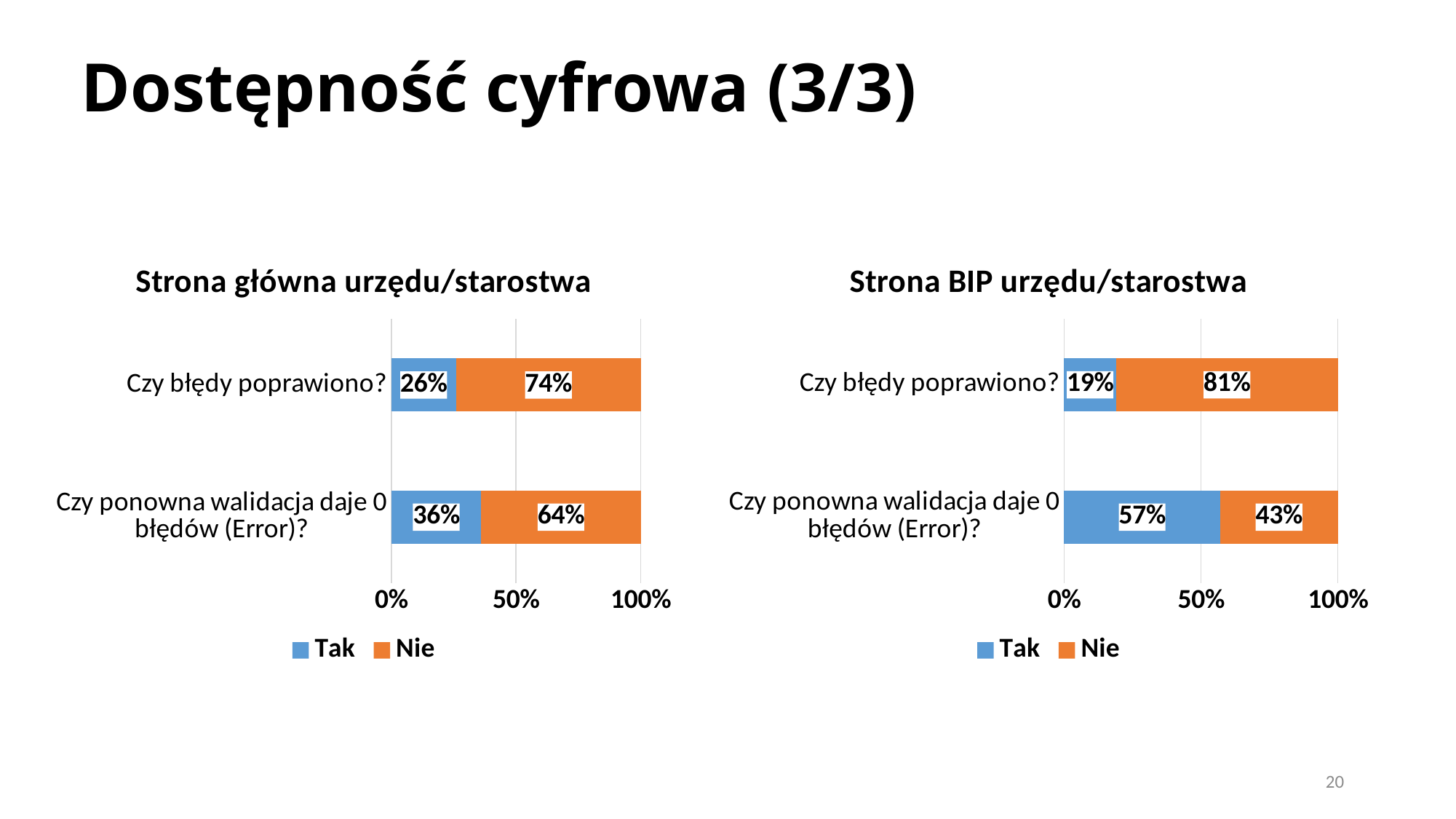
How many categories does the chart titled "Strona BIP urzędu/starostwa" show? 2 In the chart titled "Strona główna urzędu/starostwa", which is larger for "Czy ponowna walidacja daje 0 błędów (Error)?": "Tak" or "Nie"? Nie In the chart titled "Strona główna urzędu/starostwa", what is the "Tak" value for "Czy błędy poprawiono?"? 26% In the chart titled "Strona BIP urzędu/starostwa", what is the difference between the "Nie" and "Tak" values for "Czy błędy poprawiono?"? 62% In the chart titled "Strona główna urzędu/starostwa", what is the "Nie" value for "Czy ponowna walidacja daje 0 błędów (Error)?"? 64% How many series does the legend of the chart titled "Strona główna urzędu/starostwa" list? 2 In the chart titled "Strona główna urzędu/starostwa", which colour represents the "Nie" series? Orange In the chart titled "Strona BIP urzędu/starostwa", which is larger for "Czy ponowna walidacja daje 0 błędów (Error)?": "Tak" or "Nie"? Tak In the chart titled "Strona BIP urzędu/starostwa", what is the "Nie" value for "Czy błędy poprawiono?"? 81% In the chart titled "Strona BIP urzędu/starostwa", what is the "Tak" value for "Czy ponowna walidacja daje 0 błędów (Error)?"? 57% What kind of chart is the chart titled "Strona BIP urzędu/starostwa"? Stacked bar chart In the chart titled "Strona główna urzędu/starostwa", what is the total of the stacked bar for "Czy błędy poprawiono?"? 100%